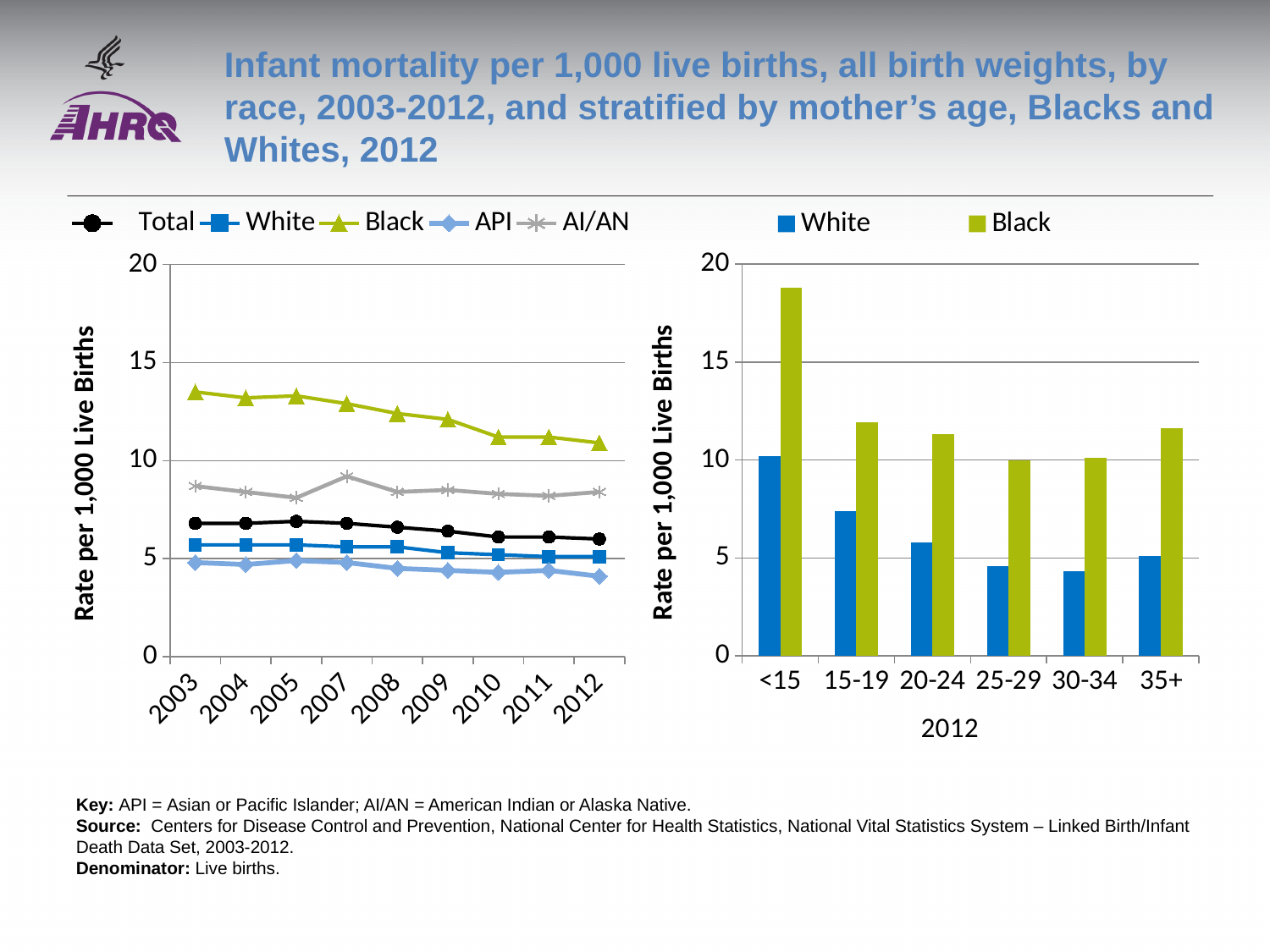
On the right chart, how many mother's age groups are shown? 6 On the left chart, which series has the highest infant mortality rate in every year shown? Black On the left chart, how many series does the legend list? 5 What kind of chart is the right chart? Bar chart On the right chart, is the White rate for mothers aged 15-19 greater or less than 10? less On the right chart, is the Black rate for mothers aged <15 greater or less than 15? greater On the left chart, which series has the lowest infant mortality rate in 2012? API On the right chart, which mother's age group has the highest Black infant mortality rate? <15 On the left chart, how many years are plotted along the x axis? 9 On the left chart, is the API rate in 2012 greater or less than 5? less On the left chart, does the Black infant mortality rate rise or fall from 2003 to 2012? Fall